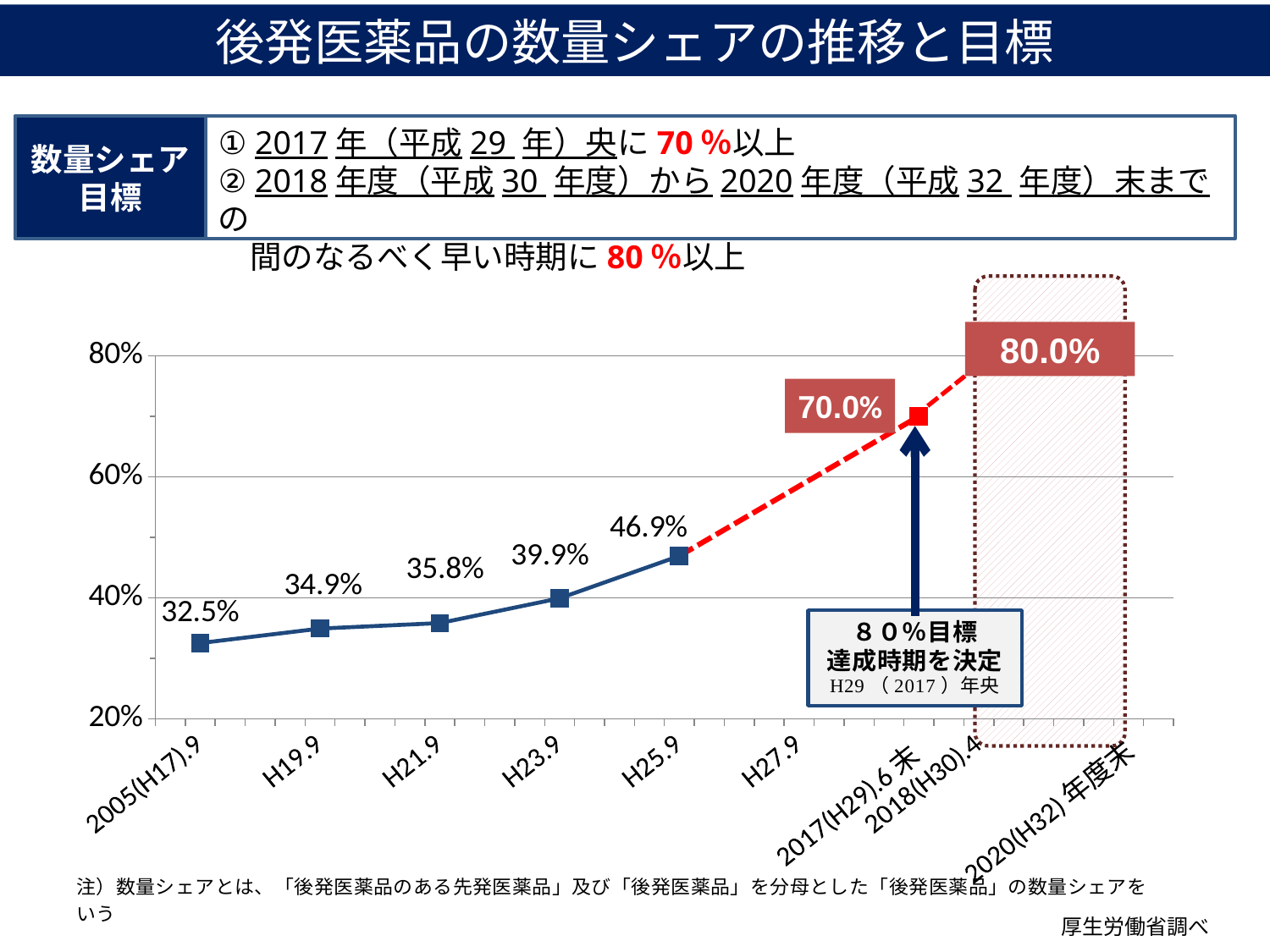
What type of chart is shown on the slide? line chart Which is larger, the value for H19.9 or the value for H23.9? H23.9 How many categories are labelled on the x axis? 9 What is the target value shown for 2017(H29).6末? 70.0% What is the value for 2005(H17).9? 32.5% What is the difference between the values for H25.9 and H23.9? 7.0% Which category has the lowest value on the chart? 2005(H17).9 What is the target value shown for 2020(H32)年度末? 80.0% What is the value for H25.9? 46.9% What is the value for H21.9? 35.8% What is the difference between the 80.0% target and the 70.0% target? 10.0% Do the values rise or fall from 2005(H17).9 to H25.9? rise